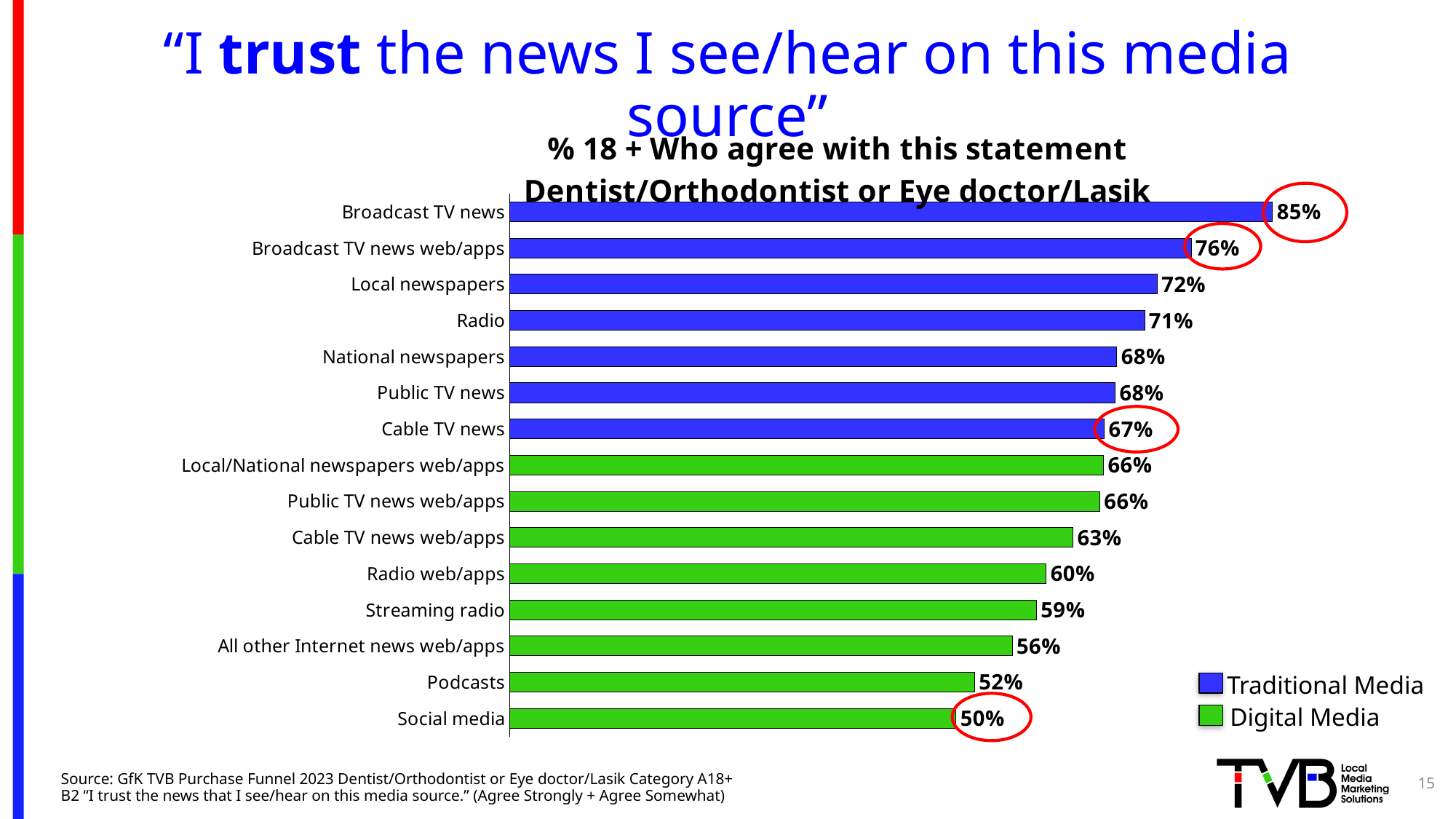
Which legend entry is represented by the green bars? Digital Media What percentage of adults 18+ agree they trust the news on Broadcast TV news? 85% How many media sources are listed in the chart? 15 What is the difference between the values for Broadcast TV news and Social media? 35 percentage points How many series does the legend list? 2 What is the difference between the values for Broadcast TV news web/apps and Cable TV news? 9 percentage points Which media source has the highest percentage of agreement? Broadcast TV news What is the value shown for Radio web/apps? 60% What is the value shown for Social media? 50% Which media source has the lowest percentage of agreement? Social media Which has a higher value, Local newspapers or Podcasts? Local newspapers What type of chart is shown on the slide? Bar chart